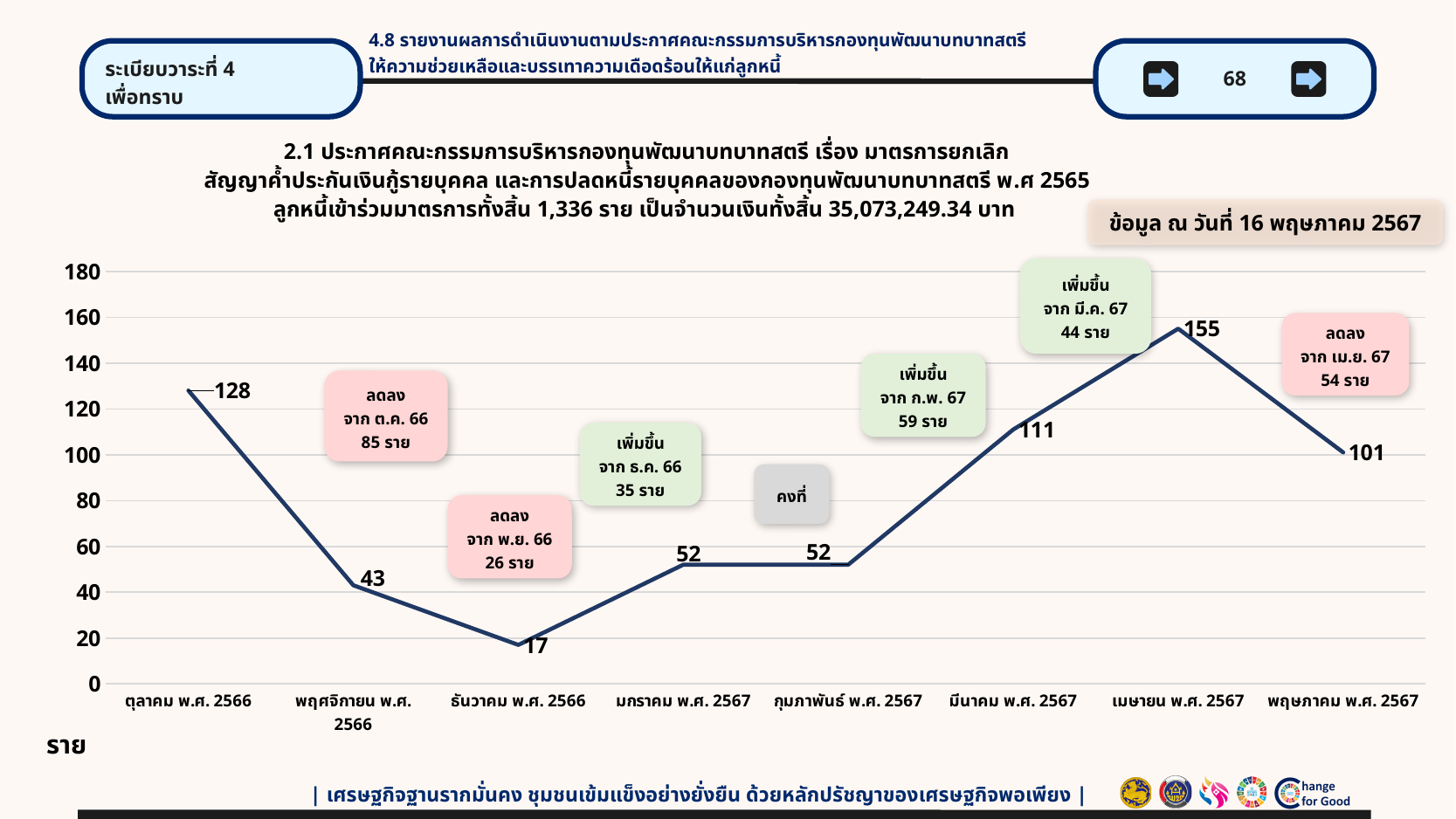
What kind of chart is shown? line chart How many months are plotted on the chart? 8 What is the date shown in the box at the top right of the chart (ข้อมูล ณ วันที่)? 16 พฤษภาคม 2567 What is the value for พฤษภาคม พ.ศ. 2567? 101 Which is larger, the value for ตุลาคม พ.ศ. 2566 or the value for มีนาคม พ.ศ. 2567? ตุลาคม พ.ศ. 2566 What is the value for ธันวาคม พ.ศ. 2566? 17 What is the value for ตุลาคม พ.ศ. 2566? 128 What is the value for เมษายน พ.ศ. 2567? 155 What is the difference between the values for เมษายน พ.ศ. 2567 and มีนาคม พ.ศ. 2567? 44 Do the values rise or fall from ธันวาคม พ.ศ. 2566 to เมษายน พ.ศ. 2567? rise Which month has the lowest value? ธันวาคม พ.ศ. 2566 Which month has the highest value? เมษายน พ.ศ. 2567